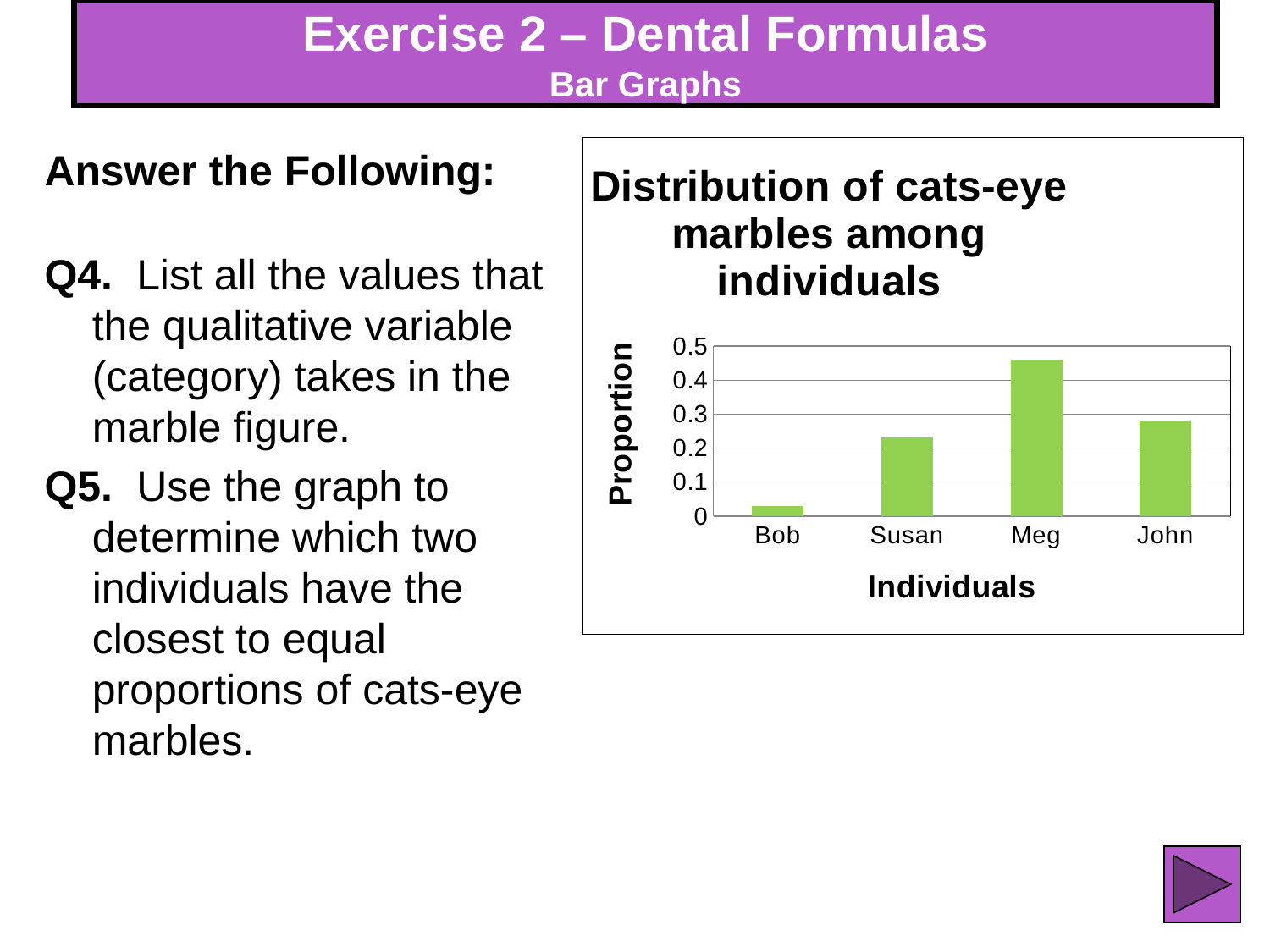
Is the proportion for Bob greater or less than 0.1? less Which individual has the lowest proportion of cats-eye marbles? Bob How many individuals are shown on the x axis of the chart? 4 What kind of chart is shown on the slide? bar chart Is the proportion for Susan greater or less than 0.3? less Which individual has the highest proportion of cats-eye marbles? Meg Who has the larger proportion of cats-eye marbles, Susan or John? John Is the proportion for Meg greater or less than 0.4? greater What is the label on the y axis of the chart? Proportion Who has the larger proportion of cats-eye marbles, Meg or John? Meg What is the title of the chart? Distribution of cats-eye marbles among individuals